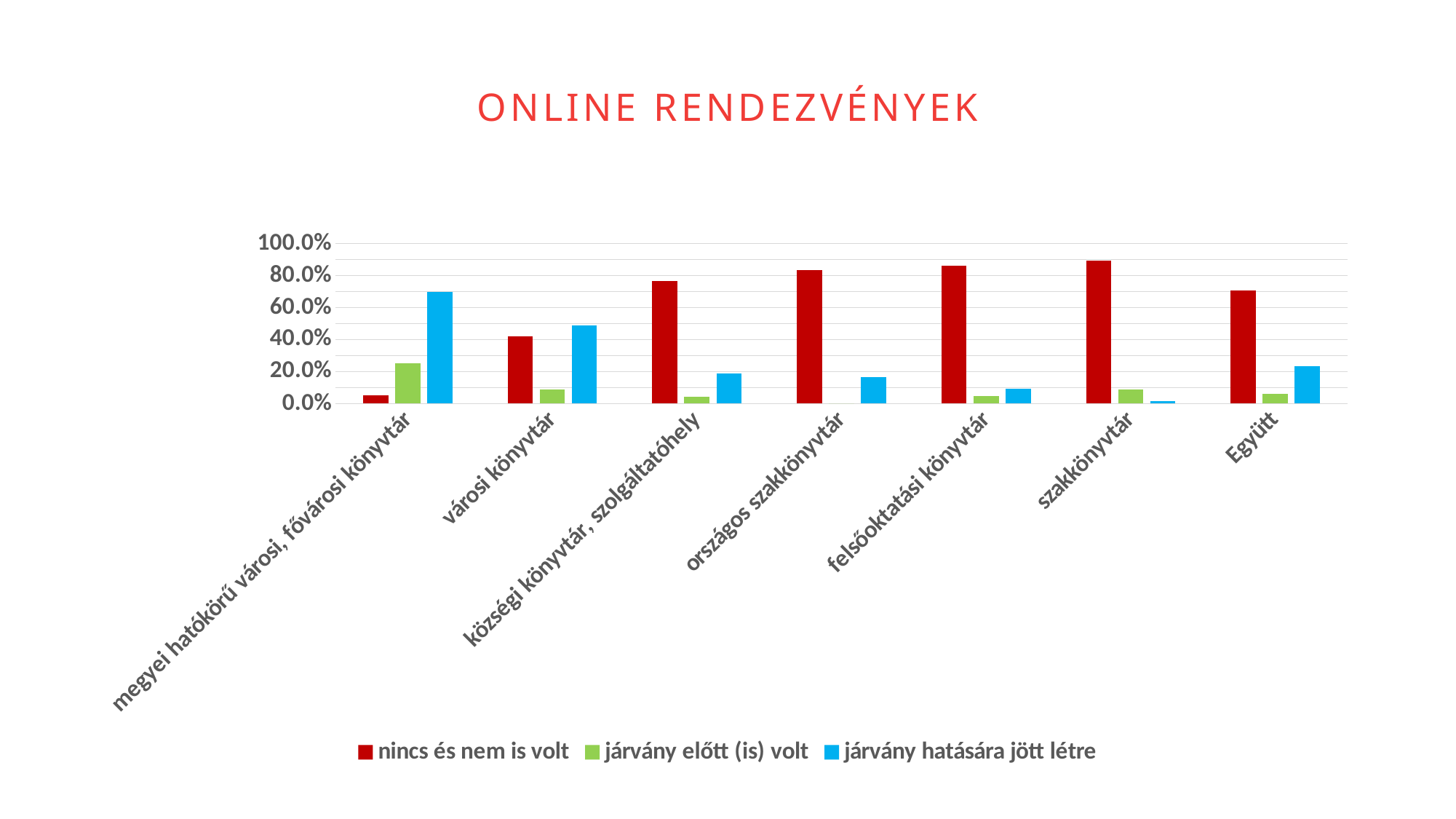
Which category has the lowest value for 'nincs és nem is volt'? megyei hatókörű városi, fővárosi könyvtár Is the value for 'nincs és nem is volt' in the 'városi könyvtár' category greater or less than 60.0%? less Is the value for 'nincs és nem is volt' in the 'szakkönyvtár' category greater or less than 80.0%? greater What type of chart is shown on the slide? bar chart Which category has the highest value for 'járvány hatására jött létre'? megyei hatókörű városi, fővárosi könyvtár What is the title of the chart? ONLINE RENDEZVÉNYEK How many series does the legend list? 3 Which category has the highest value for 'nincs és nem is volt'? szakkönyvtár Which category has the highest value for 'járvány előtt (is) volt'? megyei hatókörű városi, fővárosi könyvtár How many categories are shown on the x axis? 7 Is the value for 'járvány hatására jött létre' in the 'megyei hatókörű városi, fővárosi könyvtár' category greater or less than 60.0%? greater In the 'Együtt' category, which is larger: 'nincs és nem is volt' or 'járvány hatására jött létre'? nincs és nem is volt